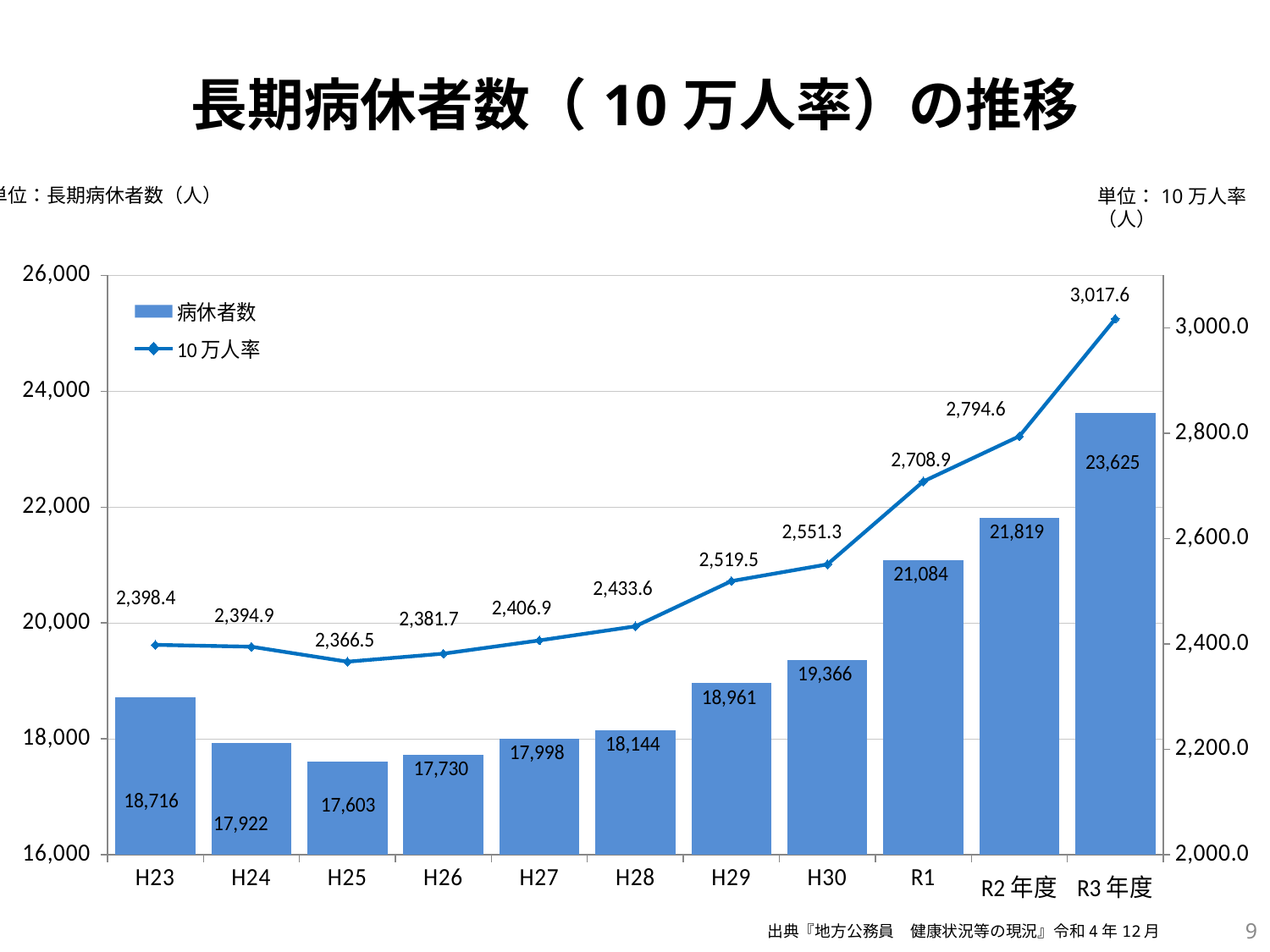
What kind of chart is shown on the slide? Combined bar and line chart Which category has the lowest 病休者数 value? H25 Do the 病休者数 values rise or fall from H25 to R3年度? Rise How many series does the legend list? 2 What is the 10万人率 value for H28? 2,433.6 What is the title of the chart on the slide? 長期病休者数（10万人率）の推移 Which category has the highest 10万人率 value? R3年度 What is the 10万人率 value for R3年度? 3,017.6 Which is larger, the 10万人率 value for H24 or for H26? H24 What is the difference in 病休者数 between R3年度 and R2年度? 1,806 How many categories are shown on the x axis? 11 What is the 病休者数 value for H23? 18,716